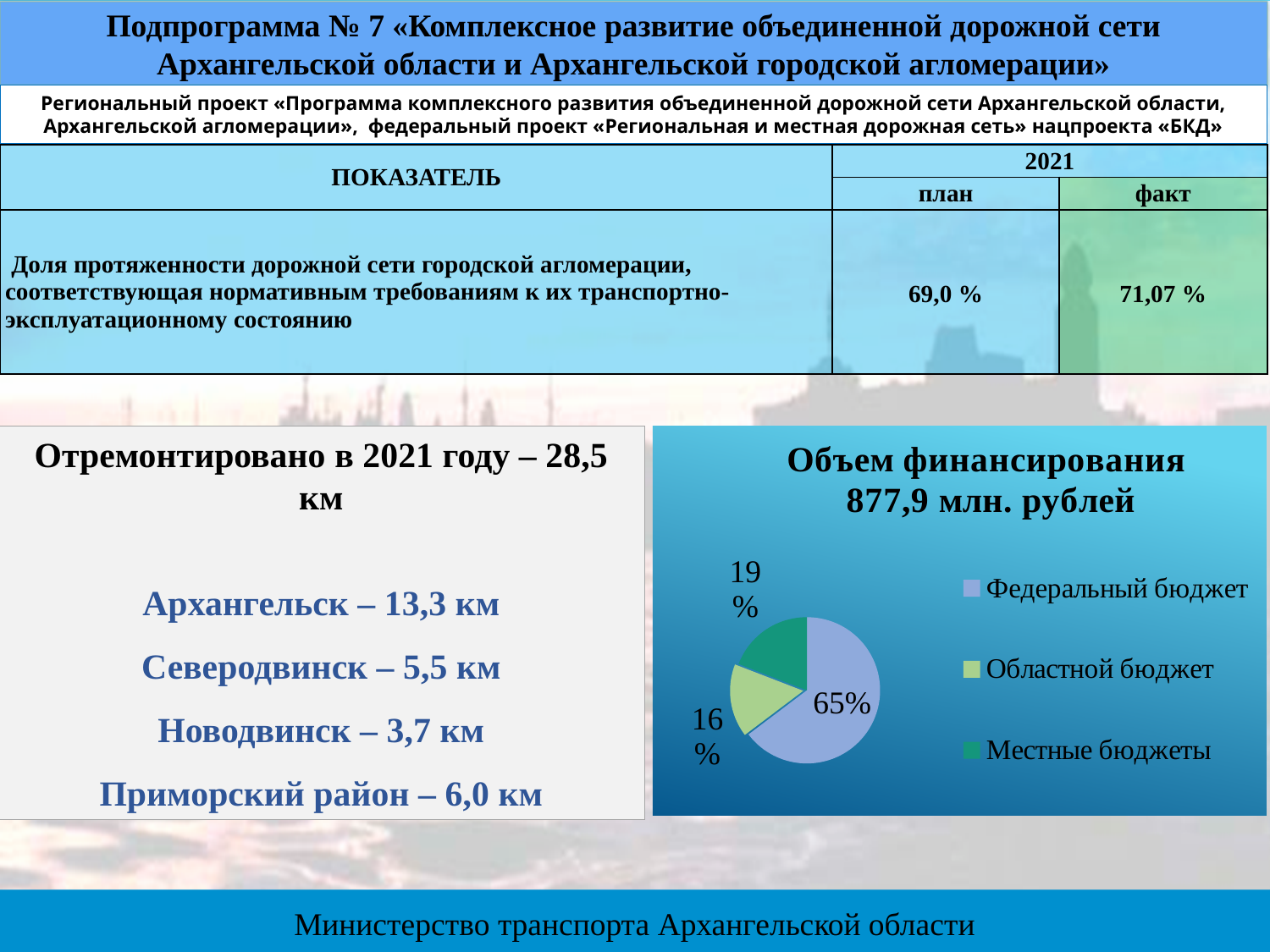
Which slice of the pie chart is the smallest? Областной бюджет Which slice of the pie chart is the largest? Федеральный бюджет In the pie chart, which is larger: Местные бюджеты or Областной бюджет? Местные бюджеты What is the difference in percentage points between the Местные бюджеты slice and the Областной бюджет slice? 3 What is the difference in percentage points between the Федеральный бюджет slice and the Местные бюджеты slice? 46 In the pie chart, what share is labelled for Федеральный бюджет? 65% In the pie chart, what share is labelled for Областной бюджет? 16% How many entries does the legend of the pie chart list? 3 In the pie chart, what share is labelled for Местные бюджеты? 19% What kind of chart is shown under the heading «Объем финансирования 877,9 млн. рублей»? pie chart What total funding amount is stated in the title above the pie chart? 877,9 млн. рублей How many slices does the pie chart have? 3